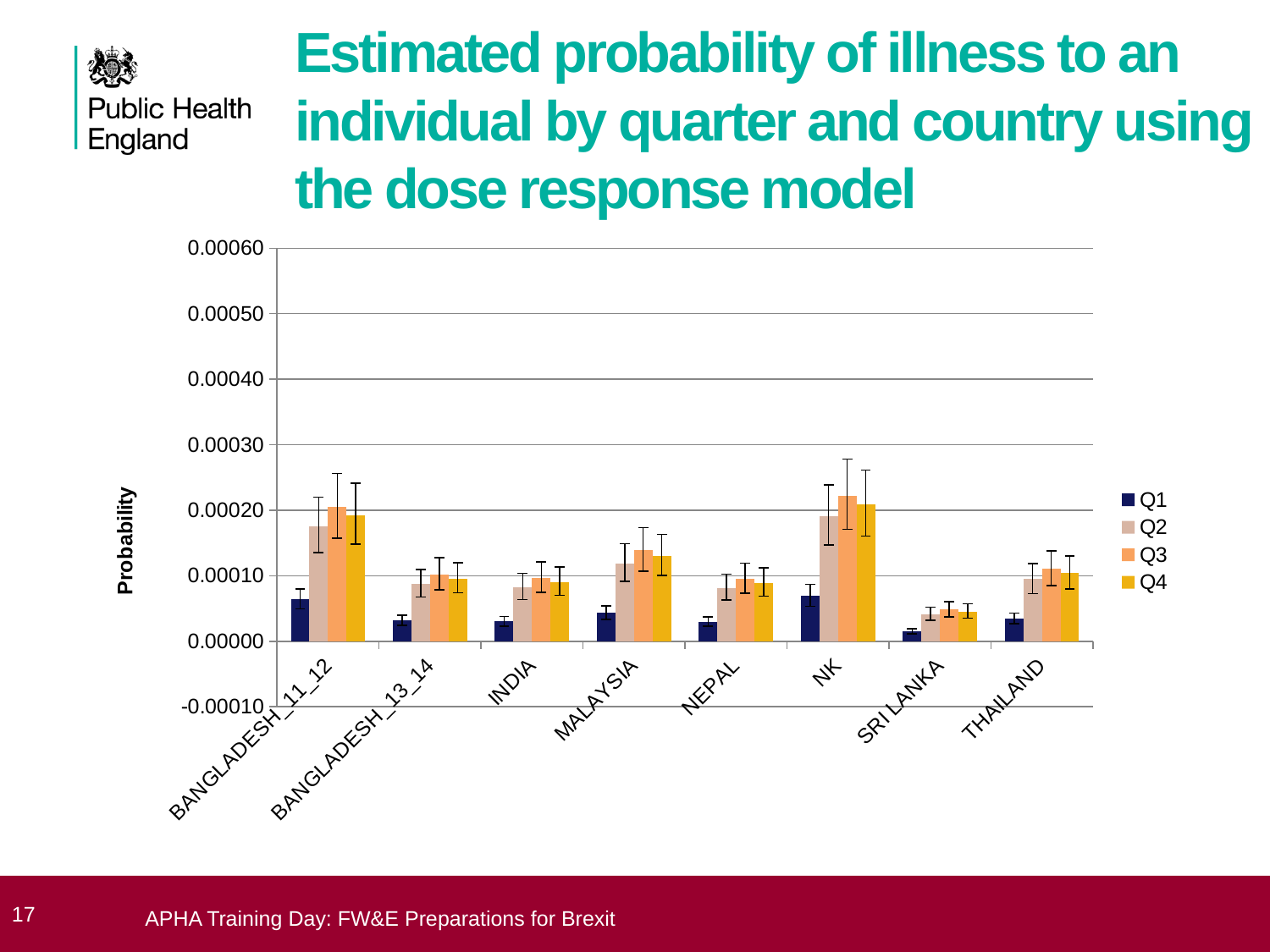
Is the Q3 value for NK greater or less than 0.00020? greater Is the Q2 value for BANGLADESH_11_12 greater or less than 0.00020? less Which country has the lowest probability values across all quarters? SRI LANKA What kind of chart is shown on the slide? bar chart For BANGLADESH_11_12, which quarter has the lowest probability? Q1 Is the Q3 value for SRI LANKA greater or less than 0.00010? less How many series does the chart legend list? 4 What are the series names listed in the chart legend? Q1, Q2, Q3, Q4 For NEPAL, which is larger: the Q1 value or the Q3 value? Q3 What is the label on the vertical axis of the chart? Probability How many countries/categories are shown on the x axis of the chart? 8